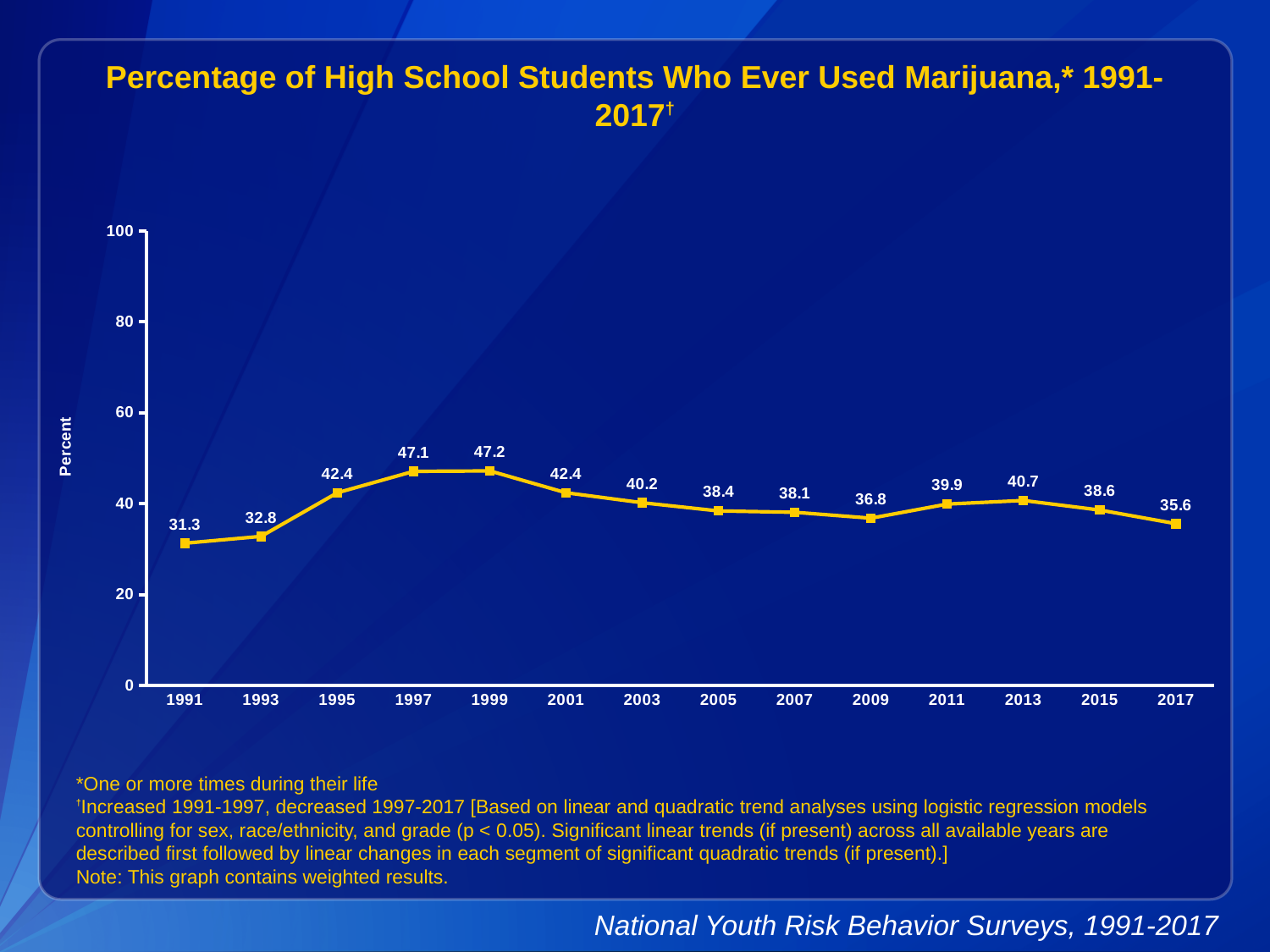
Which year has the larger value, 2013 or 2015? 2013 How many years are plotted on the x axis? 14 Which year has the highest value on the chart? 1999 What is the label on the y axis? Percent Is the value for 2001 greater or less than 40? greater What kind of chart is shown on the slide? line chart What is the value plotted for 2017? 35.6 What is the difference between the 1997 value and the 1991 value? 15.8 What percentage of high school students had ever used marijuana in 1991? 31.3 Do the values rise or fall from 1999 to 2009? fall Which year has the lowest value on the chart? 1991 What is the value plotted for 2009? 36.8